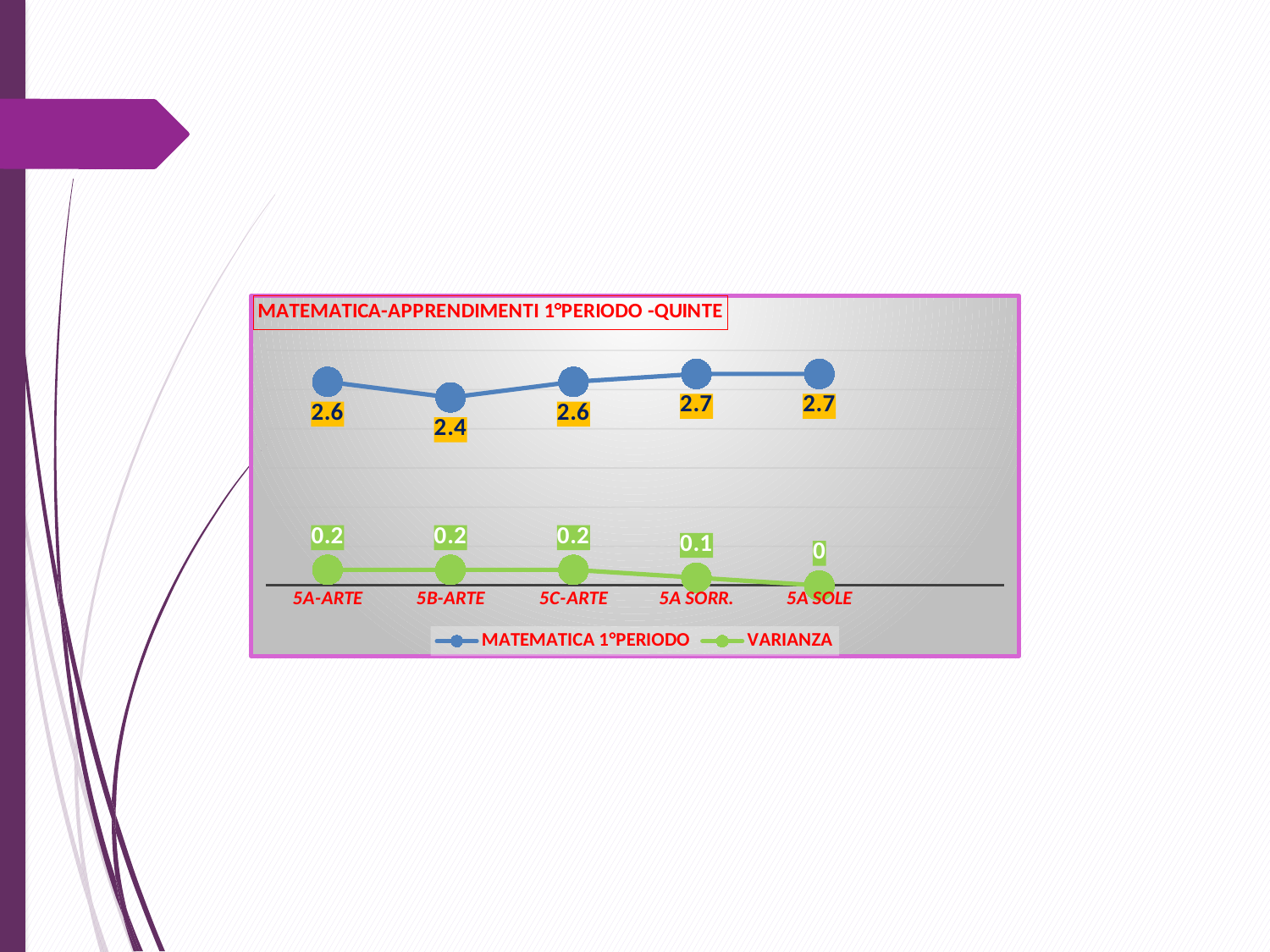
What is the MATEMATICA 1°PERIODO value for 5B-ARTE? 2.4 What is the title of the chart? MATEMATICA-APPRENDIMENTI 1°PERIODO -QUINTE What is the VARIANZA value for 5A SORR.? 0.1 Which category has the lowest VARIANZA value? 5A SOLE How many categories are shown on the x axis? 5 What kind of chart is shown on the slide? line chart Which category has the lowest MATEMATICA 1°PERIODO value? 5B-ARTE Which is larger, the MATEMATICA 1°PERIODO value for 5A-ARTE or for 5B-ARTE? 5A-ARTE What is the difference between the MATEMATICA 1°PERIODO values for 5A SORR. and 5B-ARTE? 0.3 How many series does the legend list? 2 What is the VARIANZA value for 5A SOLE? 0 What is the MATEMATICA 1°PERIODO value for 5A SOLE? 2.7